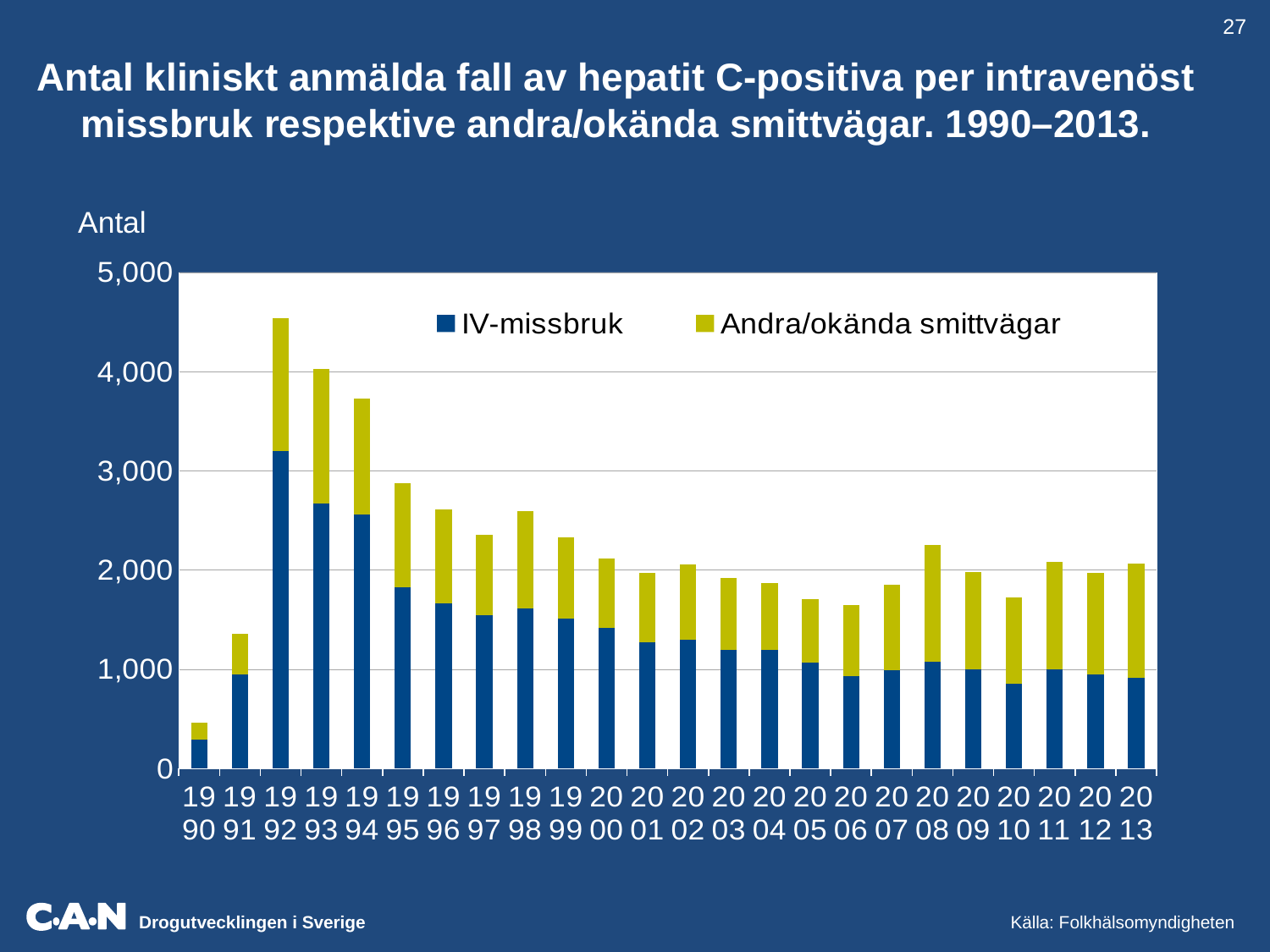
How many years are shown on the x axis? 24 Which year has the lowest total number of cases? 1990 Is the total value for 1990 greater or less than 1,000? less Which year has the highest total number of cases? 1992 What is the label on the y axis? Antal Do the total values generally rise or fall from 1992 to 2006? fall Is the IV-missbruk value for 2010 greater or less than 1,000? less Is the total value for 2008 greater or less than 2,000? greater How many series does the legend list? 2 What kind of chart is shown on the slide? stacked bar chart Which year has the larger total, 1992 or 1993? 1992